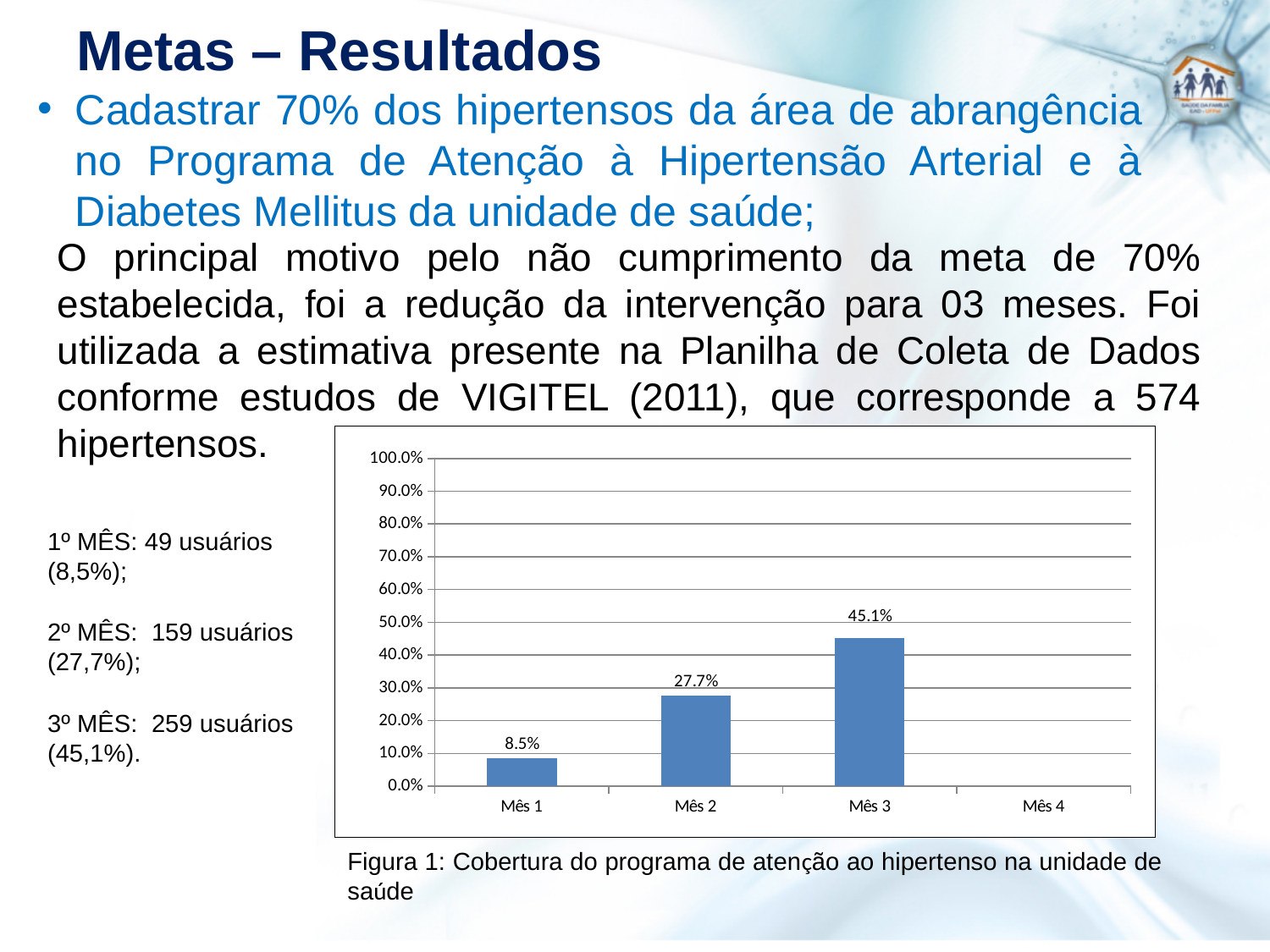
Which is larger, the value for Mês 2 or the value for Mês 3? Mês 3 Is the value for Mês 3 greater or less than 50.0%? less How many categories are shown on the x axis? 4 What is the value for Mês 1? 8.5% What is the difference between the values for Mês 2 and Mês 1? 19.2% What kind of chart is shown on the slide? bar chart What is the value for Mês 3? 45.1% Which month has the highest value? Mês 3 What is the difference between the values for Mês 3 and Mês 2? 17.4% Among the months with a plotted bar, which has the lowest value? Mês 1 What is the value for Mês 2? 27.7% Do the values rise or fall from Mês 1 to Mês 3? rise